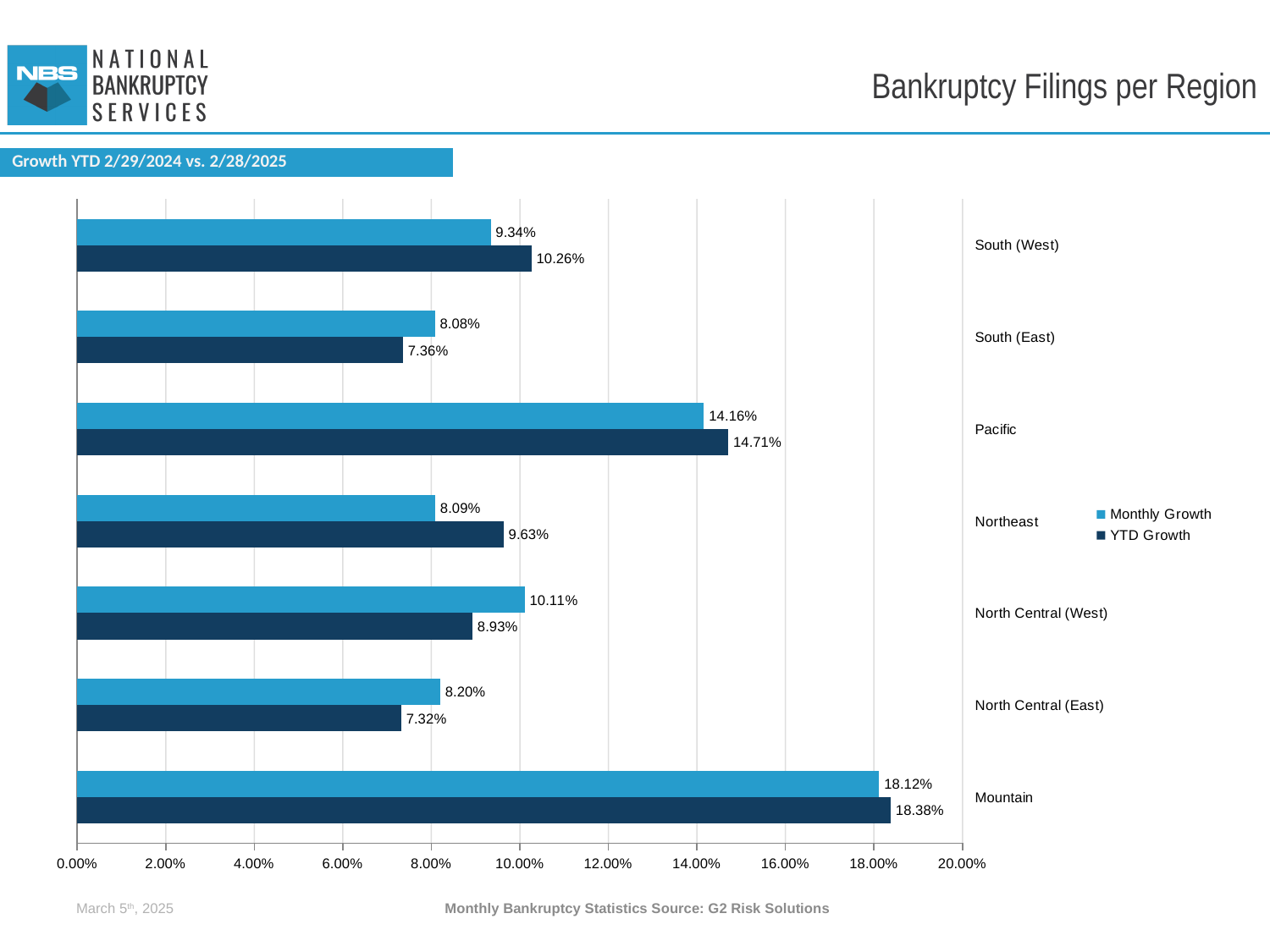
Is the Monthly Growth value for Mountain greater or less than 16.00%? greater What is the title shown above the chart? Growth YTD 2/29/2024 vs. 2/28/2025 For North Central (West), which is larger: Monthly Growth or YTD Growth? Monthly Growth What is the Monthly Growth value for the Pacific region? 14.16% What is the difference between the Monthly Growth and YTD Growth values for Northeast? 1.54% How many regions are shown on the chart? 7 Which region has the highest YTD Growth? Mountain What kind of chart is shown on the slide? Bar chart Which region has the lowest Monthly Growth? South (East) What is the YTD Growth value for North Central (East)? 7.32% What is the YTD Growth value for South (West)? 10.26% How many series does the legend list? 2